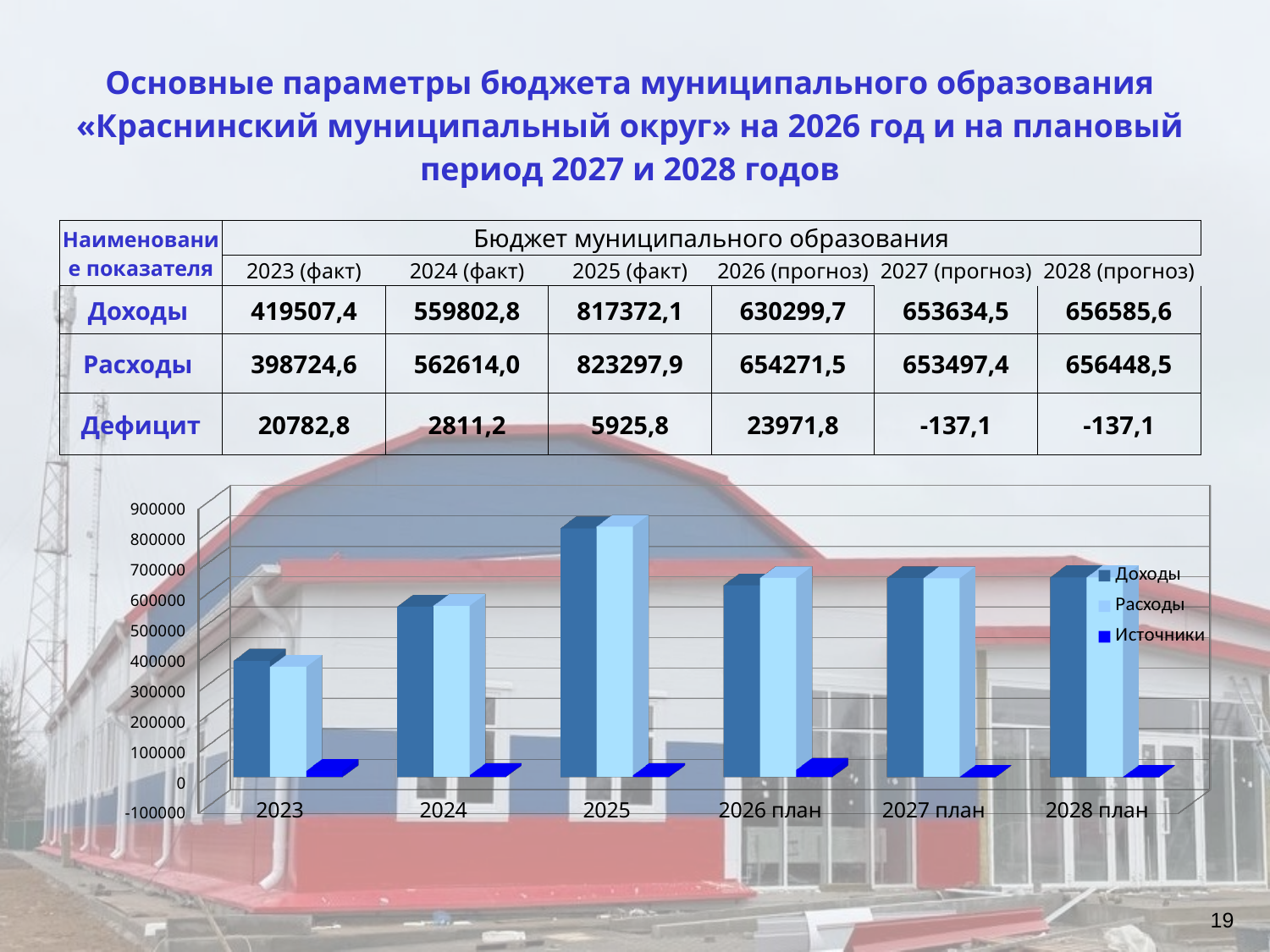
Which is larger in 2023: Доходы or Расходы? Доходы What kind of chart is shown on the slide? bar chart How many series does the chart legend list? 3 What is the value of Доходы for 2025 (факт)? 817372,1 Do the Доходы values rise or fall from 2023 to 2025? rise Which year has the highest value for Доходы? 2025 How many year categories are shown along the x axis of the chart? 6 What is the value of Расходы for 2026 (прогноз)? 654271,5 Is the value for Доходы in 2023 greater or less than 500000? less Is the value for Расходы in 2025 greater or less than 700000? greater Which year has the lowest value for Доходы? 2023 What is the difference between Доходы in 2025 and Доходы in 2023? 397864,7